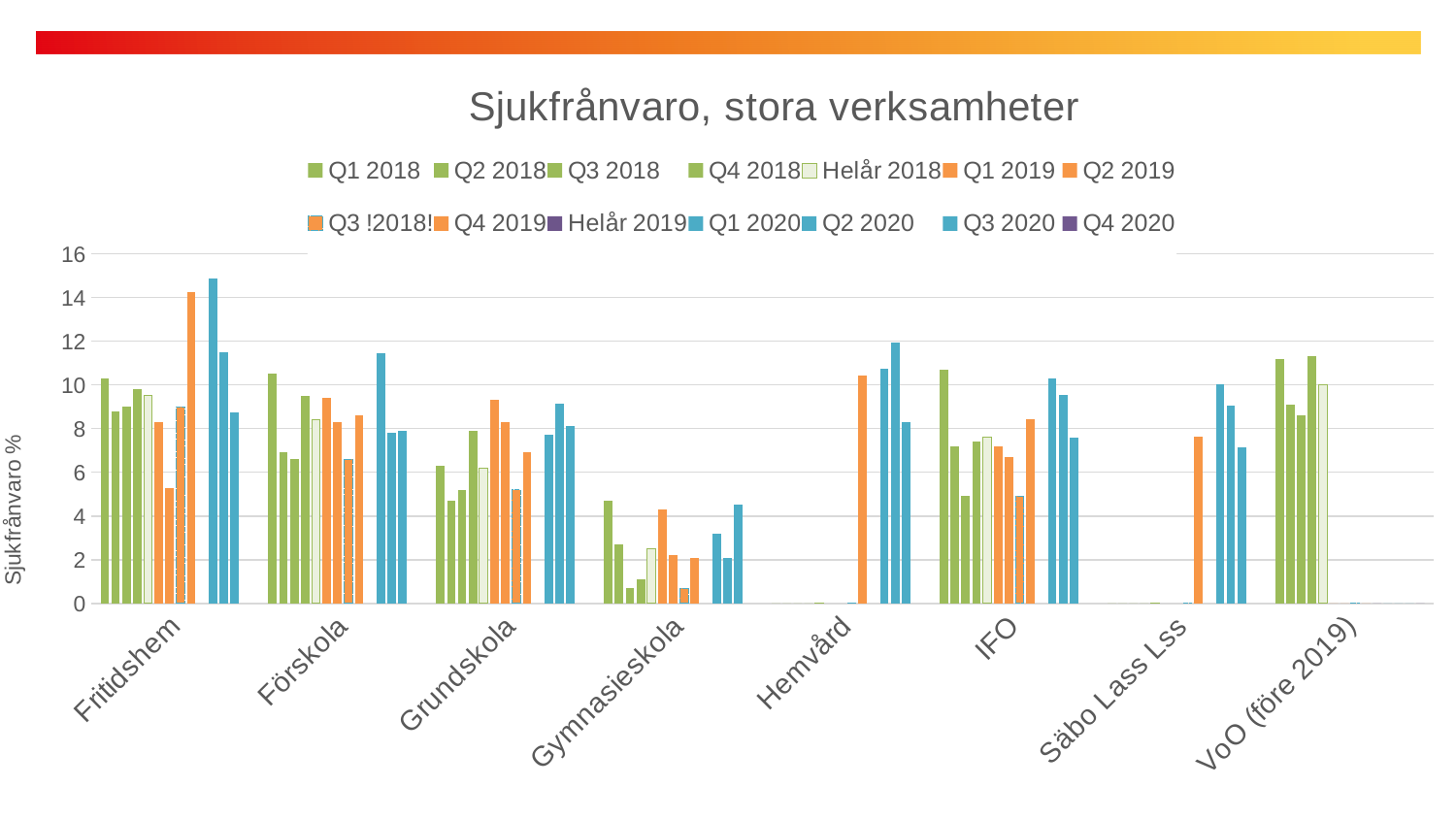
Which has the larger Q1 2018 value, Grundskola or Gymnasieskola? Grundskola Is the value for Q1 2018 in Gymnasieskola greater or less than 6? less How many categories are shown along the x axis of the chart? 8 What is the label on the vertical axis of the chart? Sjukfrånvaro % Is the value for Q4 2019 in Säbo Lass Lss greater or less than 6? greater Is the value for Q1 2020 in Fritidshem greater or less than 12? greater What type of chart is shown on the slide? bar chart What is the title of the chart? Sjukfrånvaro, stora verksamheter Which has the larger Q1 2020 value, Fritidshem or IFO? Fritidshem How many series does the legend list? 14